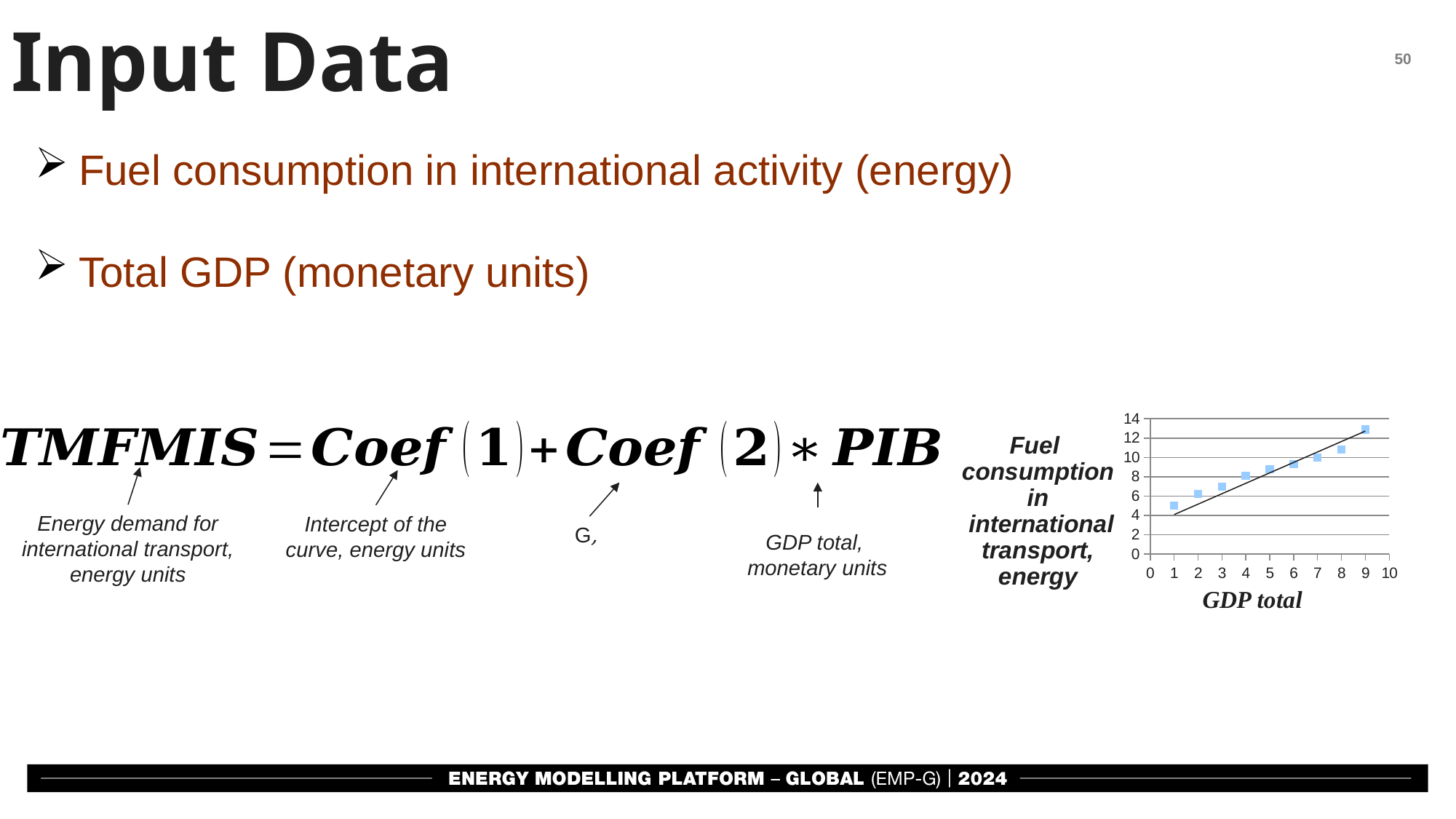
Is the fuel consumption value at GDP total 1 greater or less than 6? less At which GDP total value is the plotted fuel consumption lowest? 1 How many data points are plotted in the chart? 9 Which has the larger fuel consumption value: GDP total 2 or GDP total 8? GDP total 8 Do the plotted values rise or fall as GDP total increases? rise At which GDP total value is the plotted fuel consumption highest? 9 What kind of chart is shown on the slide? scatter chart What is the maximum value shown on the y axis of the chart? 14 What is the label of the x axis of the chart? GDP total Is the fuel consumption value at GDP total 9 greater or less than 12? greater What is the label of the y axis of the chart? Fuel consumption in international transport, energy Is the fuel consumption value at GDP total 5 greater or less than 8? greater